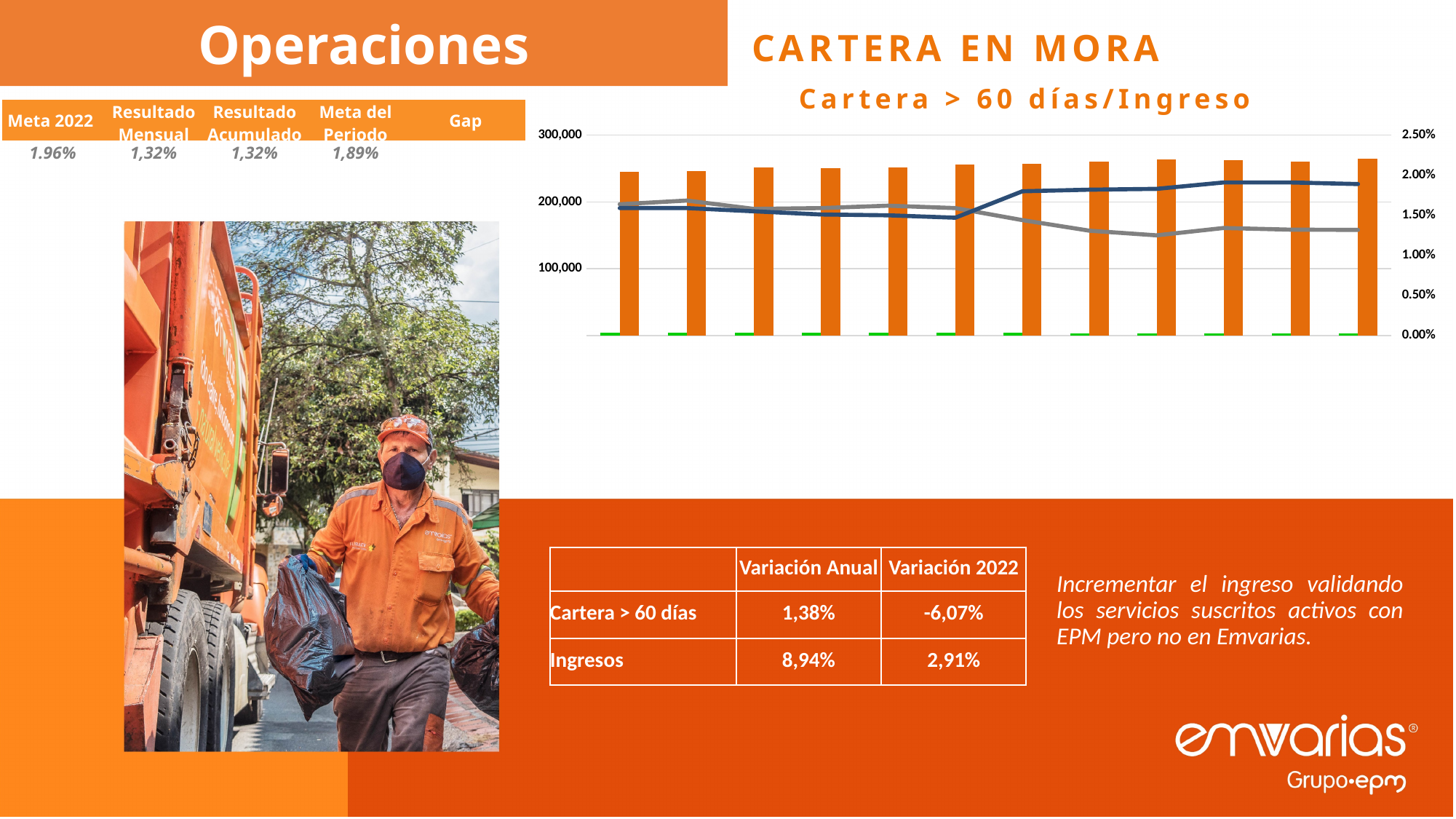
In the 'Cartera > 60 días/Ingreso' chart, does the dark blue line generally rise or fall from left to right? rise In the 'Cartera > 60 días/Ingreso' chart, does the gray line generally rise or fall from left to right? fall In the 'Cartera > 60 días/Ingreso' chart, is the value of the first orange bar greater or less than 300,000? less In the 'Cartera > 60 días/Ingreso' chart, are all the orange bars greater or less than 100,000? greater How many lines are plotted in the 'Cartera > 60 días/Ingreso' chart? 2 In the 'Cartera > 60 días/Ingreso' chart, do the orange bars generally rise or fall from left to right? rise How many orange bars are plotted in the 'Cartera > 60 días/Ingreso' chart? 12 What kind of chart is shown under the title 'Cartera > 60 días/Ingreso'? Combined bar and line chart What is the highest value shown on the left vertical axis of the 'Cartera > 60 días/Ingreso' chart? 300,000 In the 'Cartera > 60 días/Ingreso' chart, is the value of the last orange bar greater or less than 200,000? greater What is the title of the chart on the slide? Cartera > 60 días/Ingreso